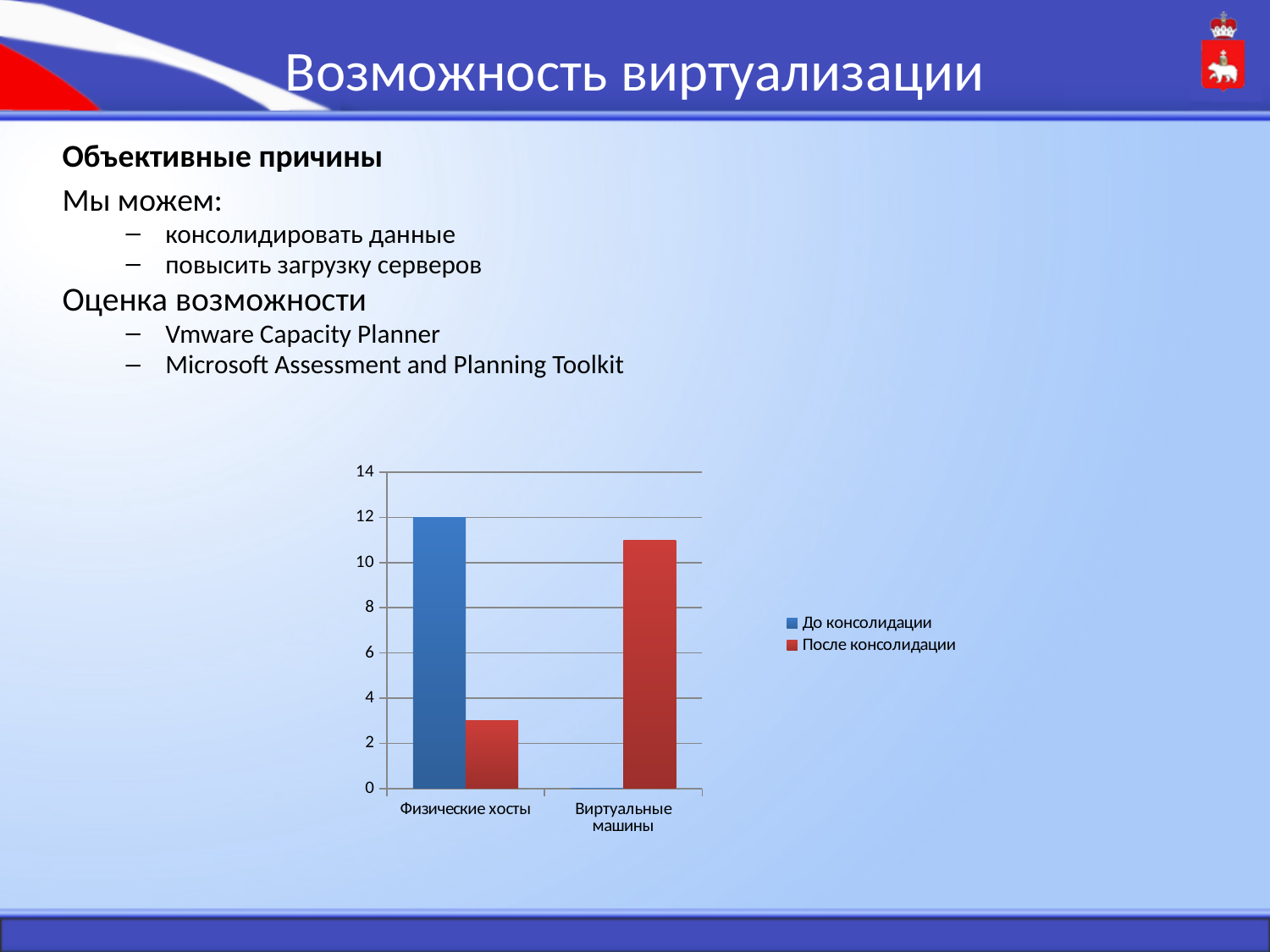
For Физические хосты, which series has the larger value: До консолидации or После консолидации? До консолидации Is the value for Физические хосты in the После консолидации series greater or less than 4? less Is the value for Виртуальные машины in the После консолидации series greater or less than 12? less How many categories are shown on the x axis of the chart? 2 What is the highest value shown on the chart's vertical axis? 14 How many series does the chart legend list? 2 Which series is shown in red in the chart? После консолидации What kind of chart is shown on the slide? bar chart Which category has the lower value in the После консолидации series? Физические хосты What is the value for Физические хосты in the До консолидации series? 12 Is the value for Виртуальные машины in the После консолидации series greater or less than 10? greater Which category has the higher value in the После консолидации series? Виртуальные машины